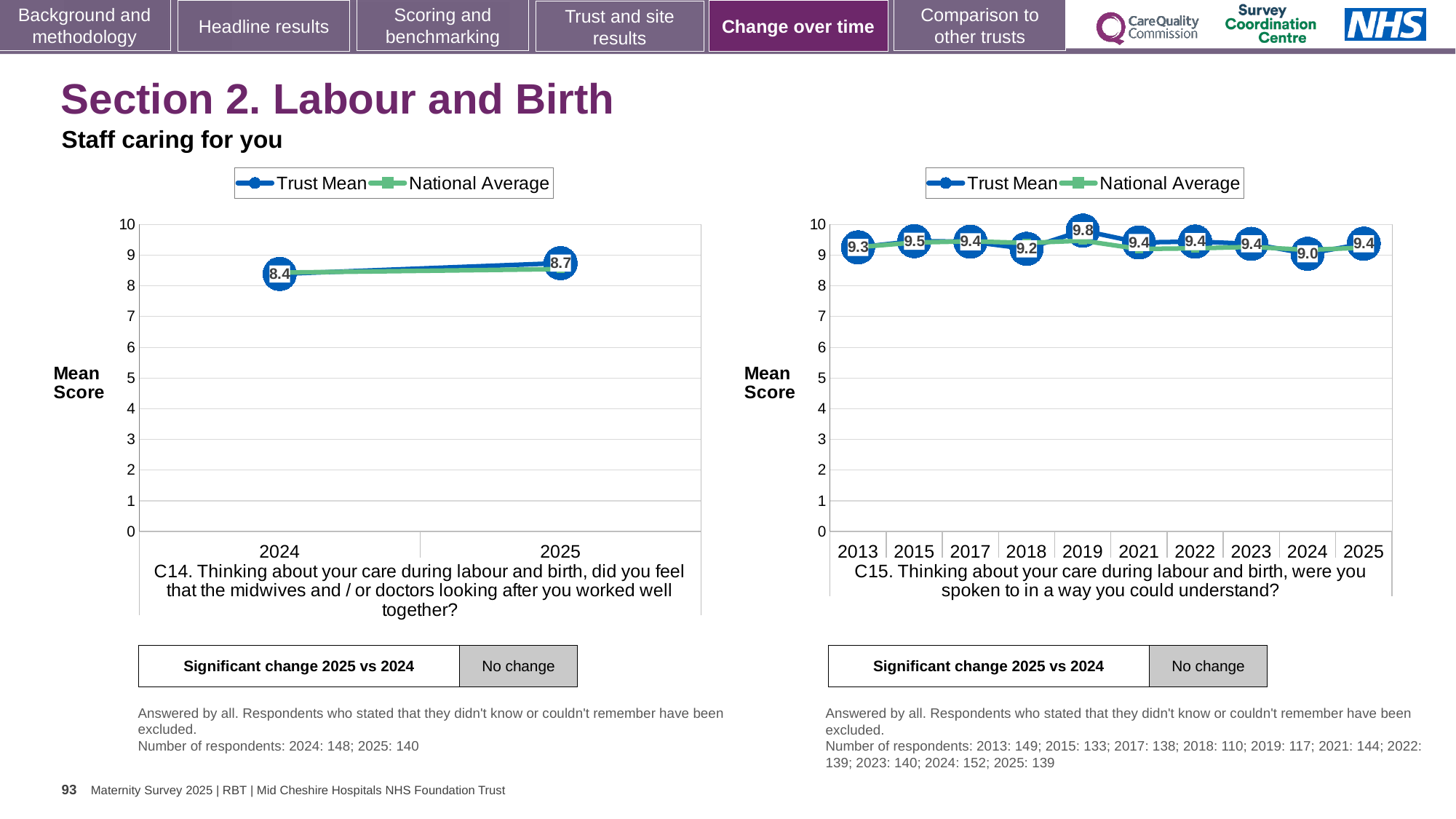
In the left chart (C14), what is the Trust Mean for 2024? 8.4 In the left chart (C14), what is the Trust Mean for 2025? 8.7 How many series does the legend of the left chart (C14) list? 2 In the left chart (C14), by how much did the Trust Mean change from 2024 to 2025? 0.3 In the right chart (C15), which year has the lowest Trust Mean? 2024 In the right chart (C15), how many years are plotted on the x axis? 10 In the left chart (C14), does the Trust Mean rise or fall from 2024 to 2025? rise In the right chart (C15), what is the Trust Mean for 2024? 9.0 In the right chart (C15), which year has the highest Trust Mean? 2019 In the right chart (C15), what is the difference between the Trust Mean in 2019 and in 2024? 0.8 What type of chart is the right chart (C15)? line chart In the right chart (C15), what is the Trust Mean for 2019? 9.8